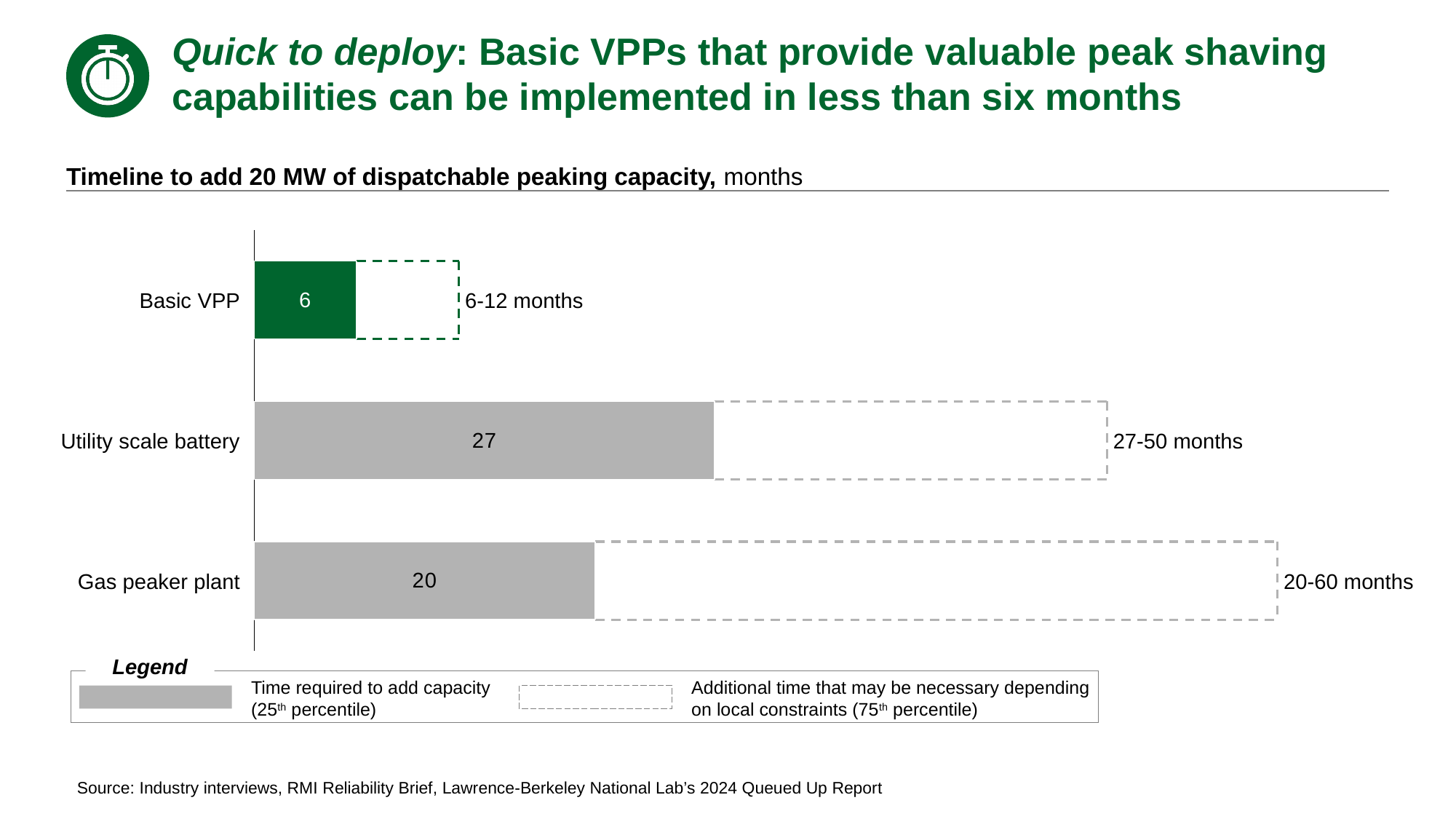
What is the time required to add capacity (25th percentile) for Gas peaker plant? 20 Which has a larger 25th percentile time required to add capacity, Gas peaker plant or Basic VPP? Gas peaker plant What is the time required to add capacity (25th percentile) for Utility scale battery? 27 What is the full timeline range shown for Utility scale battery? 27-50 months What is the time required to add capacity (25th percentile) for Basic VPP? 6 Which category has the shortest 25th percentile time required to add capacity? Basic VPP What is the title of the chart? Timeline to add 20 MW of dispatchable peaking capacity, months Which category has the longest 25th percentile time required to add capacity? Utility scale battery What kind of chart is shown on the slide? Bar chart What is the difference between the 25th percentile times for Utility scale battery and Gas peaker plant? 7 What is the full timeline range shown for Gas peaker plant? 20-60 months How many categories are shown in the chart? 3